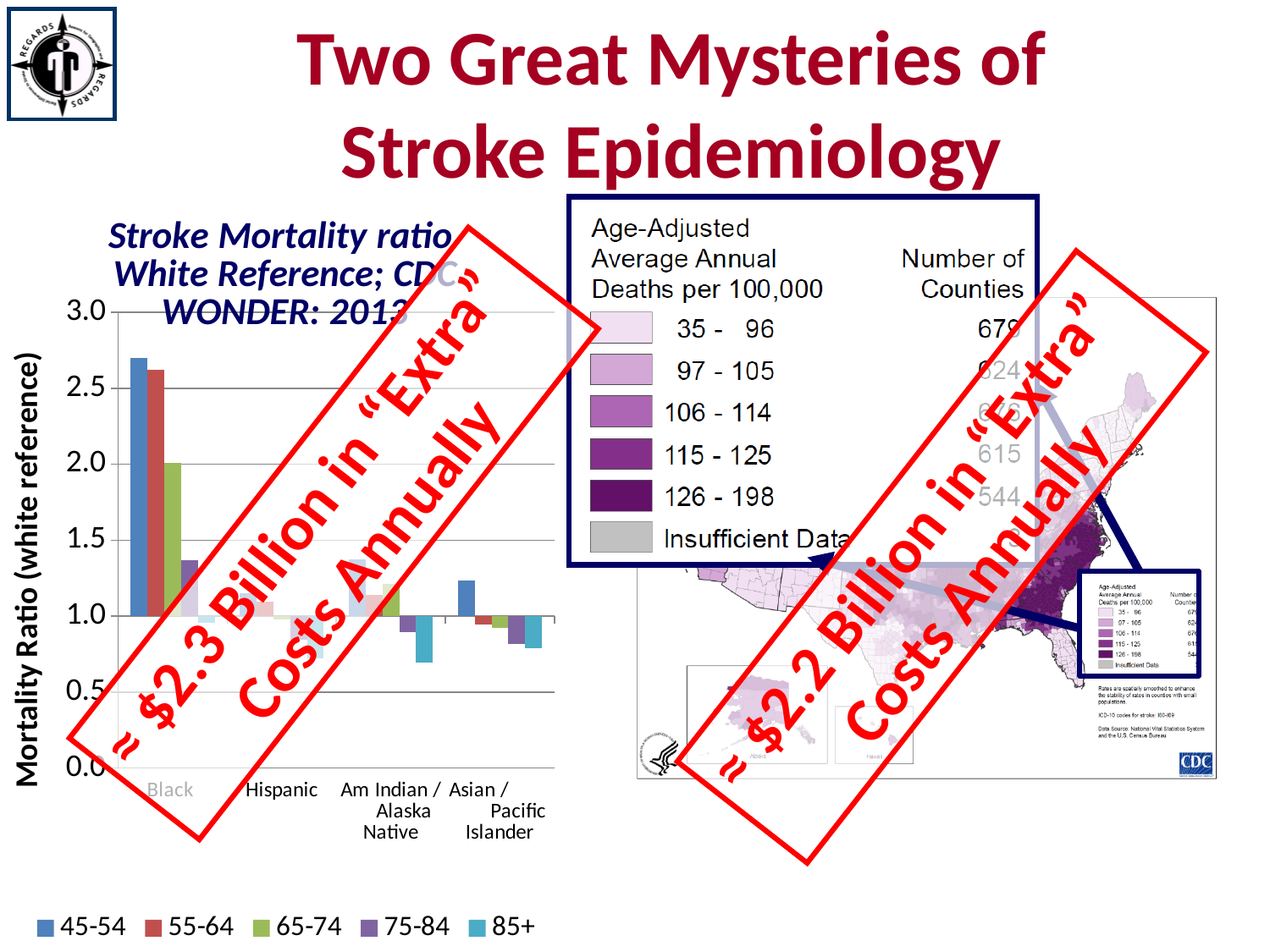
In the Stroke Mortality ratio bar chart, is the value for Asian / Pacific Islander in the 85+ age group greater or less than 1.0? less What is the y-axis label of the Stroke Mortality ratio bar chart? Mortality Ratio (white reference) In the Stroke Mortality ratio bar chart, which age group does the legend list first? 45-54 In the Stroke Mortality ratio bar chart, is the value for Asian / Pacific Islander in the 45-54 age group greater or less than 1.0? greater What kind of chart is the Stroke Mortality ratio chart on the left of the slide? bar chart In the Stroke Mortality ratio bar chart, is the value for Black in the 45-54 age group greater or less than 2.5? greater How many racial/ethnic categories are shown on the x axis of the Stroke Mortality ratio bar chart? 4 In the Stroke Mortality ratio bar chart, do the values for Black rise or fall as the age group increases from 45-54 to 85+? fall How many series does the legend of the Stroke Mortality ratio bar chart list? 5 In the Stroke Mortality ratio bar chart, which is larger for Black: the 45-54 bar or the 75-84 bar? 45-54 In the Stroke Mortality ratio bar chart, which category has the tallest bar? Black